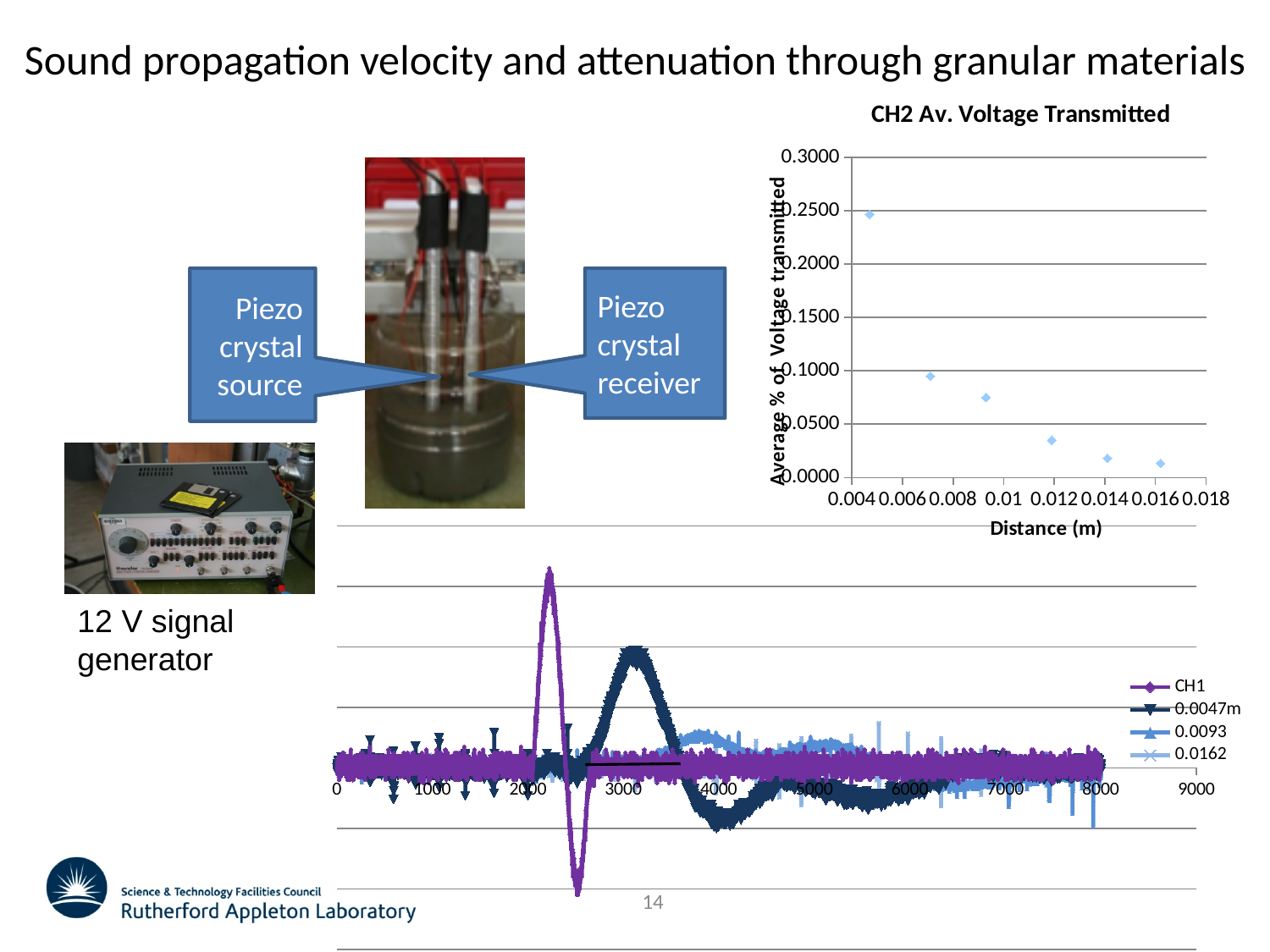
How many data points are plotted in the 'CH2 Av. Voltage Transmitted' chart? 6 In the 'CH2 Av. Voltage Transmitted' chart, is the value of the point near 0.012 m greater or less than 0.0500? less In the 'CH2 Av. Voltage Transmitted' chart, which point has the highest value: the one at the smallest distance or the one at the largest distance? the one at the smallest distance What is the x-axis title of the 'CH2 Av. Voltage Transmitted' chart? Distance (m) In the 'CH2 Av. Voltage Transmitted' chart, is the value of the point at the largest distance greater or less than 0.0500? less In the 'CH2 Av. Voltage Transmitted' chart, is the value of the point at the smallest distance greater or less than 0.2000? greater What kind of chart is the 'CH2 Av. Voltage Transmitted' chart? scatter chart What is the largest x-axis tick value shown on the bottom chart? 9000 In the 'CH2 Av. Voltage Transmitted' chart, do the values rise or fall as distance increases? fall How many series does the legend of the bottom chart list? 4 What kind of chart is the bottom chart on the slide? line chart What is the y-axis title of the 'CH2 Av. Voltage Transmitted' chart? Average % of Voltage transmitted